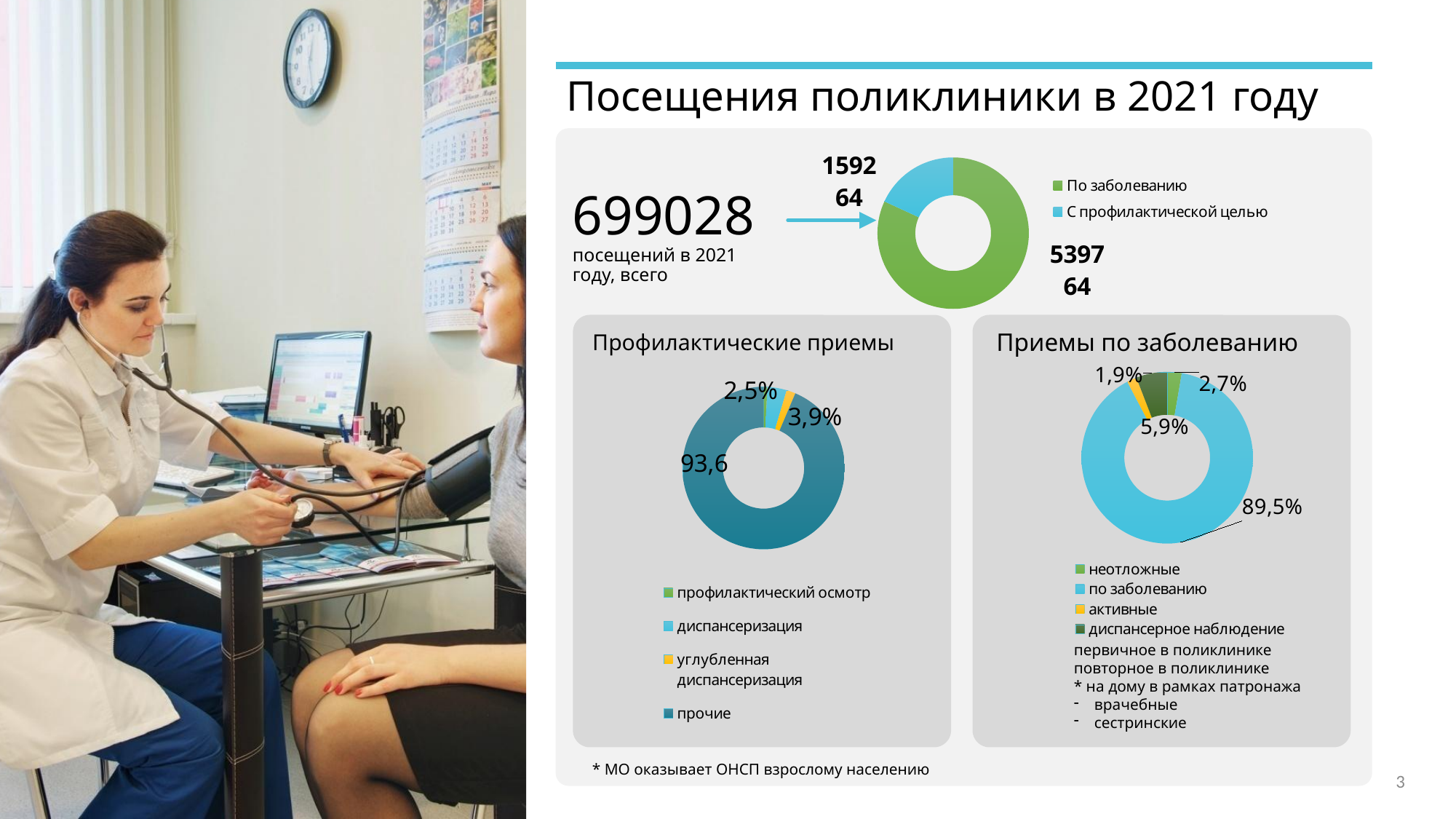
In the chart titled Приемы по заболеванию, what share is shown for диспансерное наблюдение? 5,9% In the top donut chart, how many categories does the legend list? 2 In the chart titled Приемы по заболеванию, what share is shown for по заболеванию? 89,5% What total number of clinic visits in 2021 is shown next to the top donut chart? 699028 In the chart titled Профилактические приемы, how many categories does the legend list? 4 In the chart titled Приемы по заболеванию, what is the difference between the shares for неотложные (2,7%) and активные (1,9%)? 0,8% In the top donut chart, which category is larger: По заболеванию or С профилактической целью? По заболеванию In the chart titled Приемы по заболеванию, which category has the smallest share? активные In the chart titled Профилактические приемы, what value is shown for прочие? 93,6 In the chart titled Профилактические приемы, what value is shown for углубленная диспансеризация? 3,9% What kind of chart is the top chart next to the total of 699028 visits? Donut (pie) chart In the chart titled Профилактические приемы, which category has the largest share? прочие